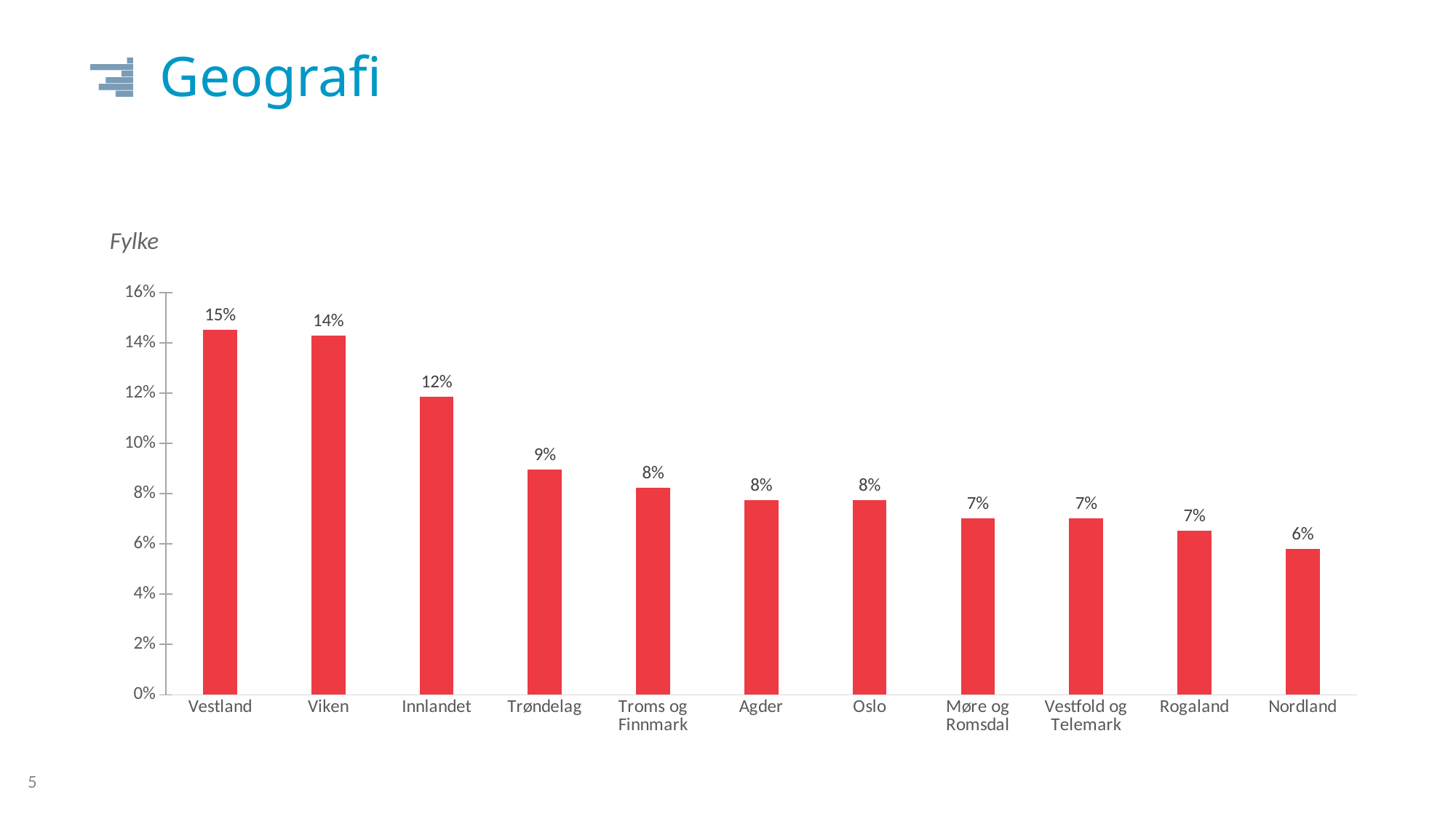
Which category has the highest value? Vestland How many categories are shown on the x axis? 11 Is the value for Viken greater or less than 10%? greater What is the value for Vestland? 15% What is the value for Innlandet? 12% What is the difference between the values for Vestland and Nordland? 9% What is the value for Nordland? 6% Which category has the lowest value? Nordland Which is larger, the value for Innlandet or the value for Trøndelag? Innlandet What kind of chart is shown on the slide? bar chart Do the values rise or fall from left to right along the x axis? fall What is the value for Trøndelag? 9%